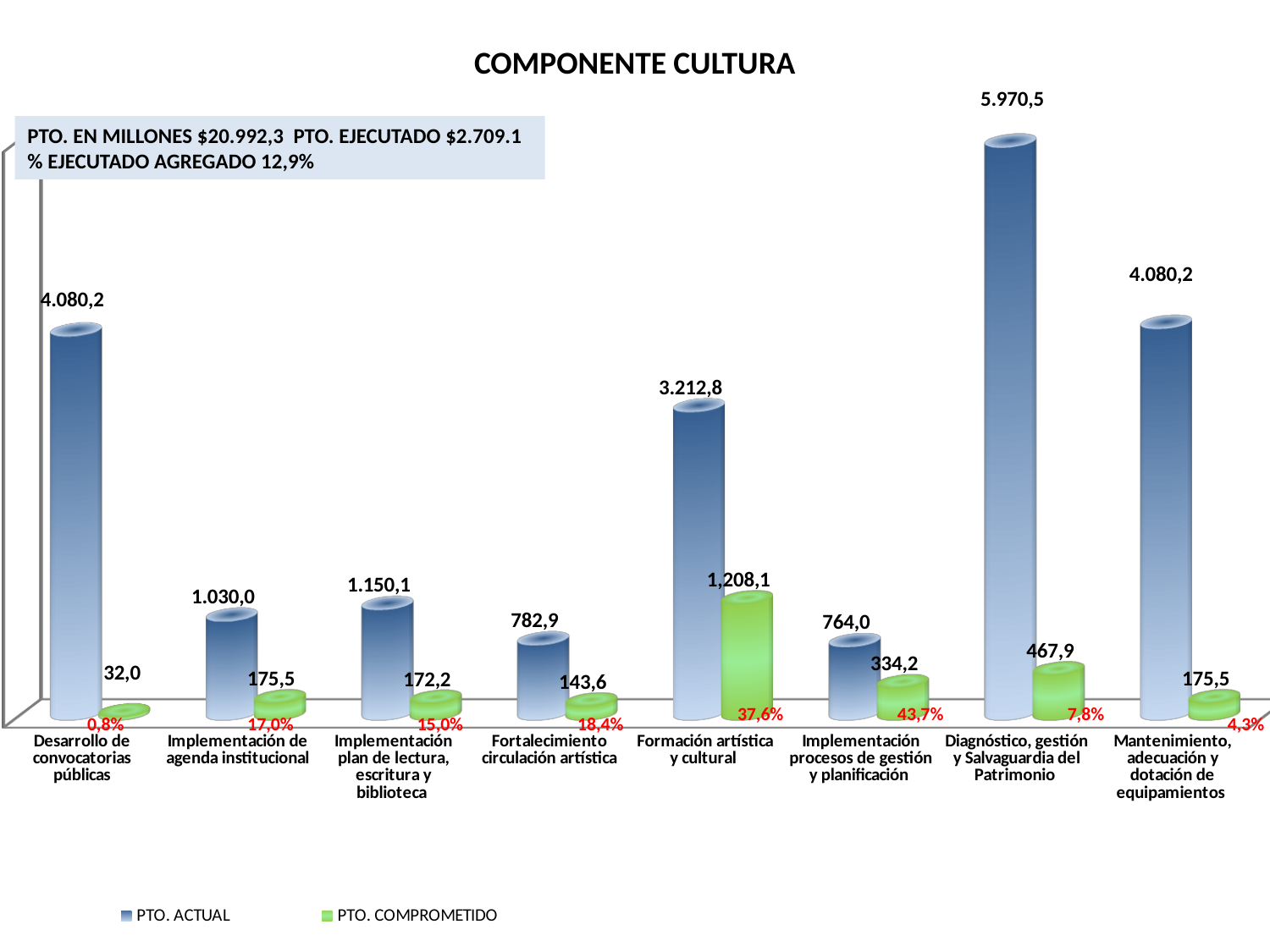
What is the difference between the PTO. ACTUAL values for Diagnóstico, gestión y Salvaguardia del Patrimonio and Mantenimiento, adecuación y dotación de equipamientos? 1.890,3 How many series does the legend list? 2 What type of chart is shown on the slide? Bar chart Which category has the lowest PTO. COMPROMETIDO value? Desarrollo de convocatorias públicas What is the PTO. ACTUAL value for Fortalecimiento circulación artística? 782,9 What is the PTO. ACTUAL value for Diagnóstico, gestión y Salvaguardia del Patrimonio? 5.970,5 Which category has the highest PTO. ACTUAL value? Diagnóstico, gestión y Salvaguardia del Patrimonio Which is larger, the PTO. COMPROMETIDO value for Implementación procesos de gestión y planificación or for Diagnóstico, gestión y Salvaguardia del Patrimonio? Diagnóstico, gestión y Salvaguardia del Patrimonio What percentage is shown in red for Implementación procesos de gestión y planificación? 43,7% What is the PTO. COMPROMETIDO value for Formación artística y cultural? 1,208,1 What is the title of the chart? COMPONENTE CULTURA How many categories are shown on the x axis? 8